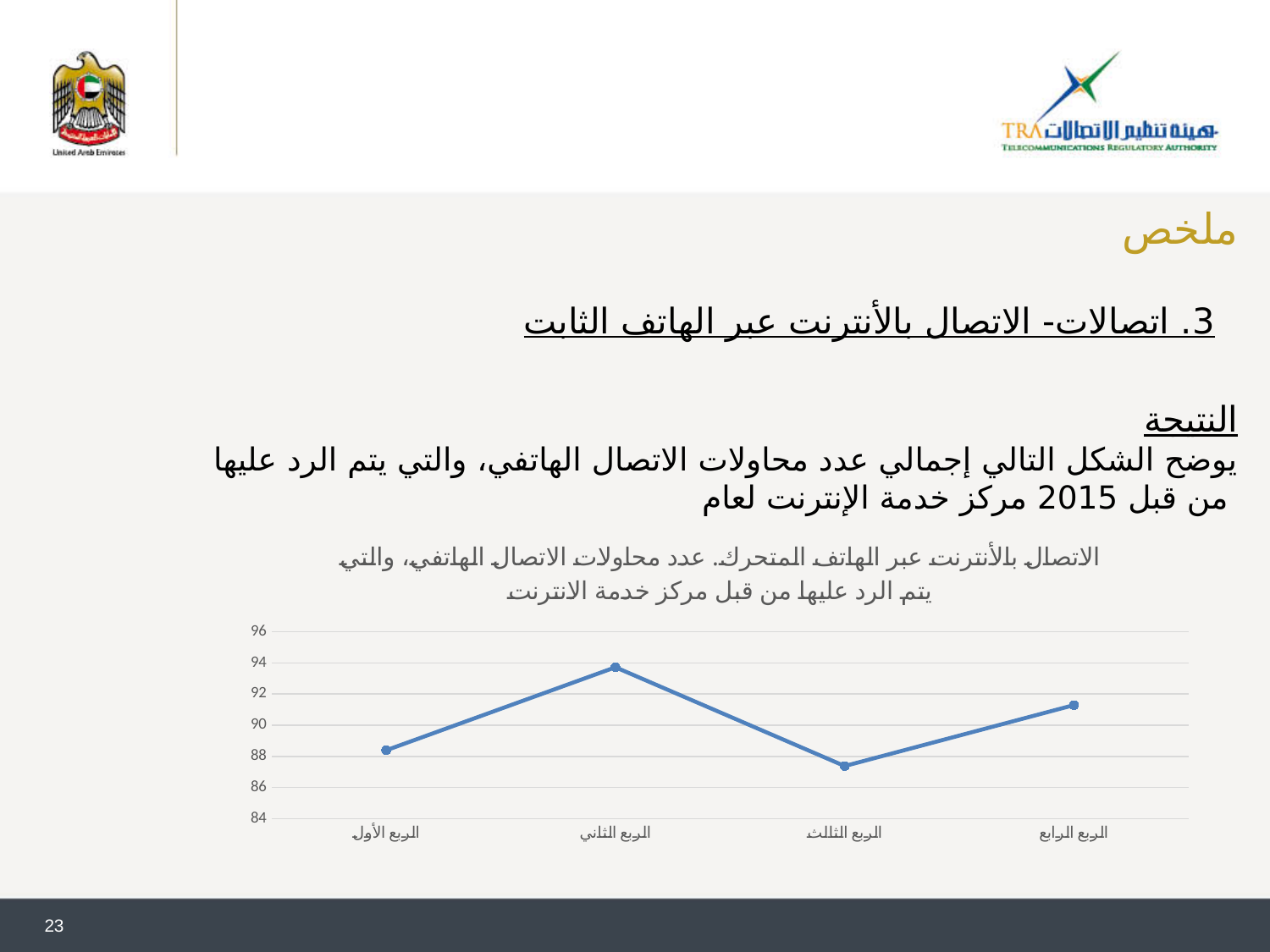
Is the value for الربع الثاني greater or less than 92? greater Does the value rise or fall from الربع الثالث to الربع الرابع? rise Which quarter has the lowest value in the chart? الربع الثالث Is the value for الربع الثالث greater or less than 88? less Is the value for الربع الأول greater or less than 90? less Which is larger, the value for الربع الأول or the value for الربع الرابع? الربع الرابع What is the lowest value shown on the y axis of the chart? 84 Which quarter has the highest value in the chart? الربع الثاني What kind of chart is shown on the slide? line chart How many quarters are plotted on the x axis of the chart? 4 Which is larger, the value for الربع الثاني or the value for الربع الثالث? الربع الثاني